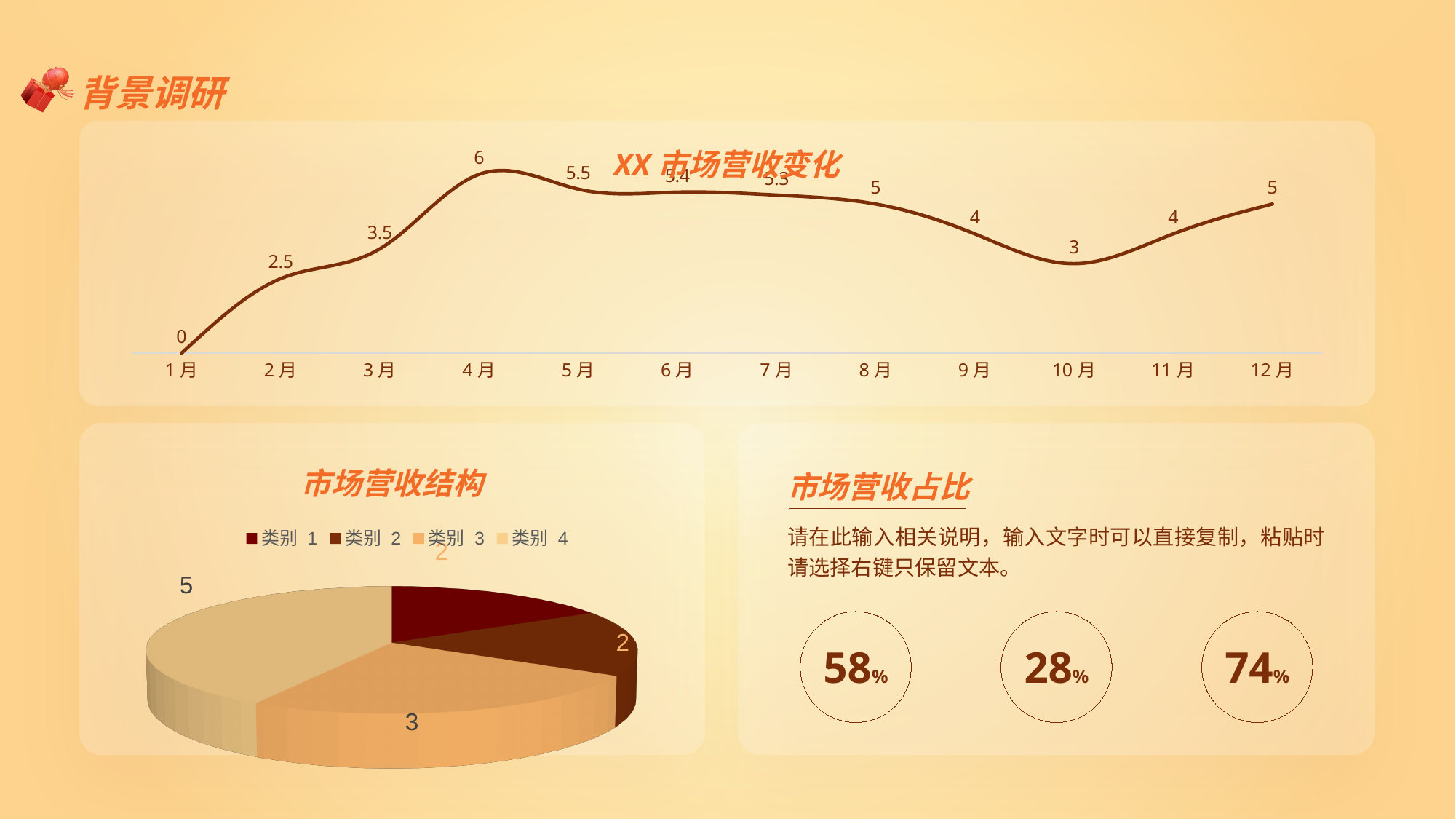
In the line chart titled XX 市场营收变化, which month has the lowest value? 1月 In the line chart titled XX 市场营收变化, which month has the highest value? 4月 In the pie chart titled 市场营收结构, which category has the largest slice? 类别 4 In the line chart titled XX 市场营收变化, which is larger, the value for 2月 or the value for 9月? 9月 How many entries does the legend of the pie chart titled 市场营收结构 list? 4 In the line chart titled XX 市场营收变化, do the values rise or fall from 1月 to 4月? rise In the pie chart titled 市场营收结构, what is the value for 类别 4? 5 What kind of chart is the chart titled XX 市场营收变化? line chart How many months are plotted in the line chart titled XX 市场营收变化? 12 In the line chart titled XX 市场营收变化, what is the value for 4月? 6 In the line chart titled XX 市场营收变化, what is the value for 12月? 5 In the line chart titled XX 市场营收变化, what is the difference between the values for 4月 and 10月? 3